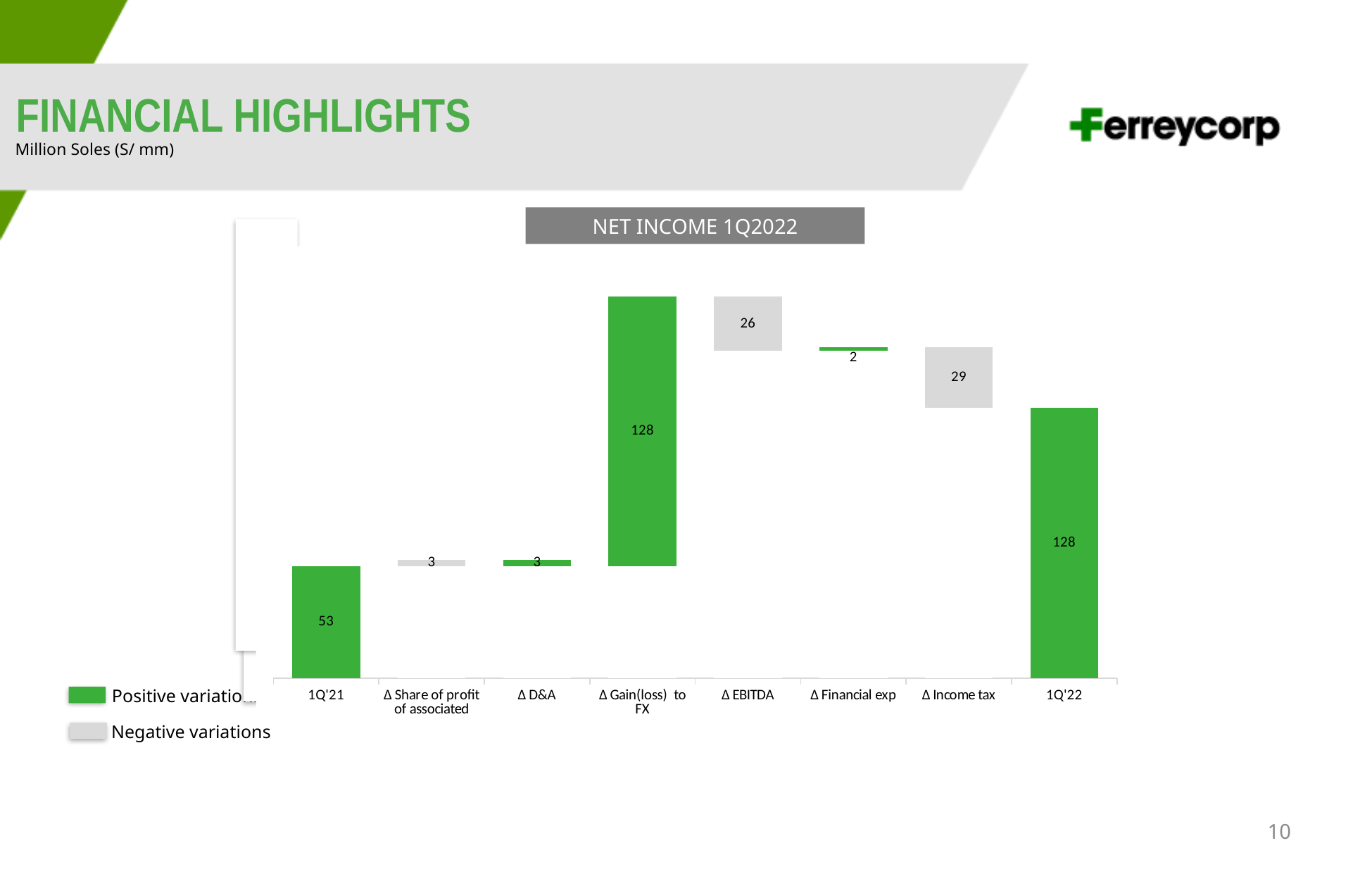
What is the value shown for Δ Gain(loss) to FX? 128 Is the value for Δ Income tax larger or smaller than the value for Δ EBITDA? larger How many categories are shown along the x axis of the chart? 8 What is the value shown for Δ Income tax? 29 What is the value for 1Q'21 in the NET INCOME 1Q2022 chart? 53 What is the difference between the 1Q'22 and 1Q'21 net income values? 75 What is the value shown for Δ Financial exp? 2 According to the legend, what colour represents negative variations? Grey Which variation category has the largest value in the chart? Δ Gain(loss) to FX What is the value for 1Q'22 in the NET INCOME 1Q2022 chart? 128 What is the value shown for Δ EBITDA? 26 Which variation category has the smallest value in the chart? Δ Financial exp